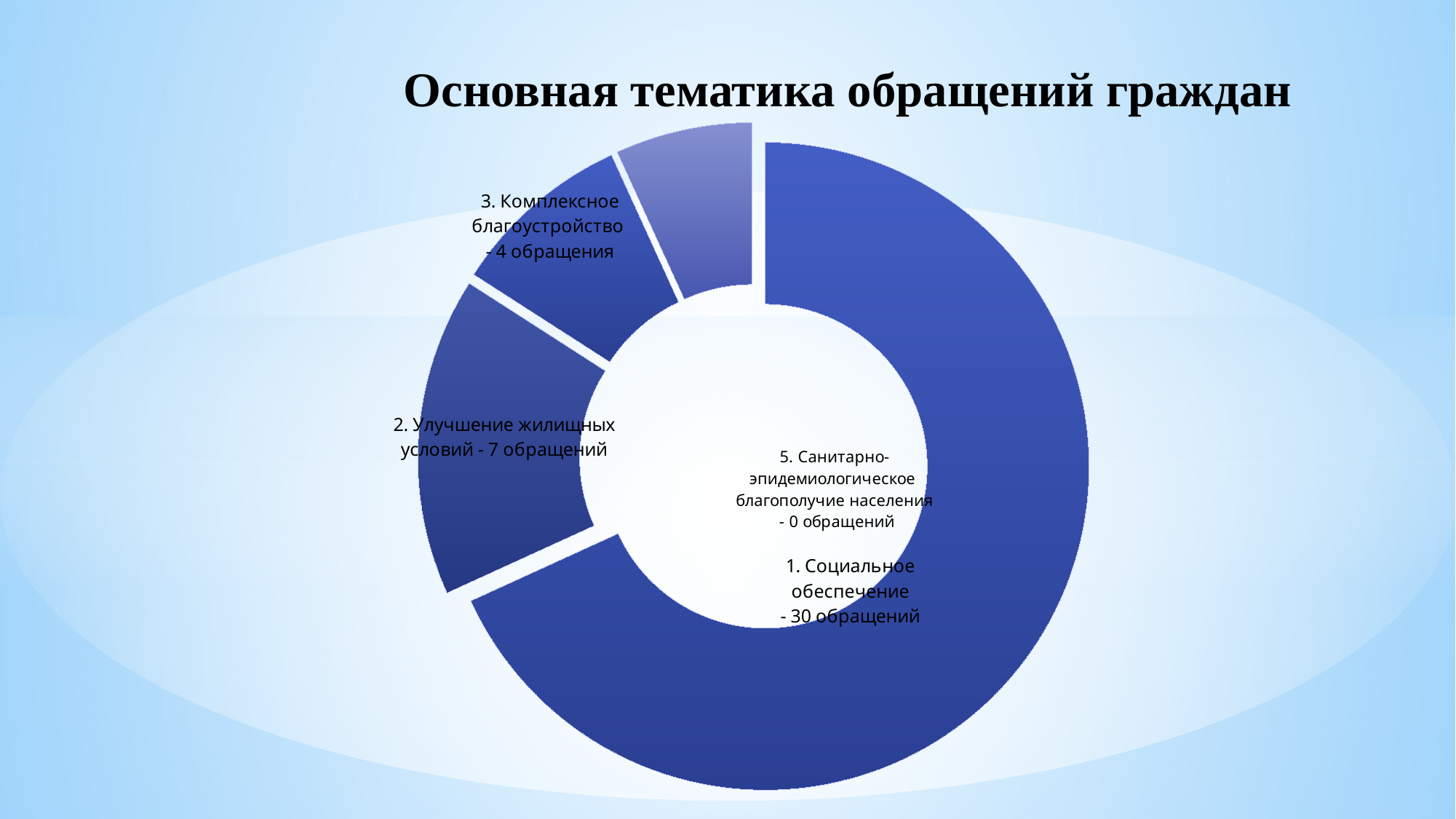
Which labeled category has the largest number of обращений? 1. Социальное обеспечение What is the difference in обращений between "1. Социальное обеспечение" and "2. Улучшение жилищных условий"? 23 How many обращений are shown for "5. Санитарно-эпидемиологическое благополучие населения"? 0 обращений What is the difference in обращений between "2. Улучшение жилищных условий" and "3. Комплексное благоустройство"? 3 Which has more обращений: "1. Социальное обеспечение" or "3. Комплексное благоустройство"? 1. Социальное обеспечение What kind of chart is shown on the slide? Doughnut (pie) chart What is the title of the chart? Основная тематика обращений граждан How many обращения are shown for "3. Комплексное благоустройство"? 4 обращения How many обращений are shown for "1. Социальное обеспечение"? 30 обращений Which labeled category has the smallest number of обращений? 5. Санитарно-эпидемиологическое благополучие населения How many обращений are shown for "2. Улучшение жилищных условий"? 7 обращений Which has more обращений: "2. Улучшение жилищных условий" or "3. Комплексное благоустройство"? 2. Улучшение жилищных условий